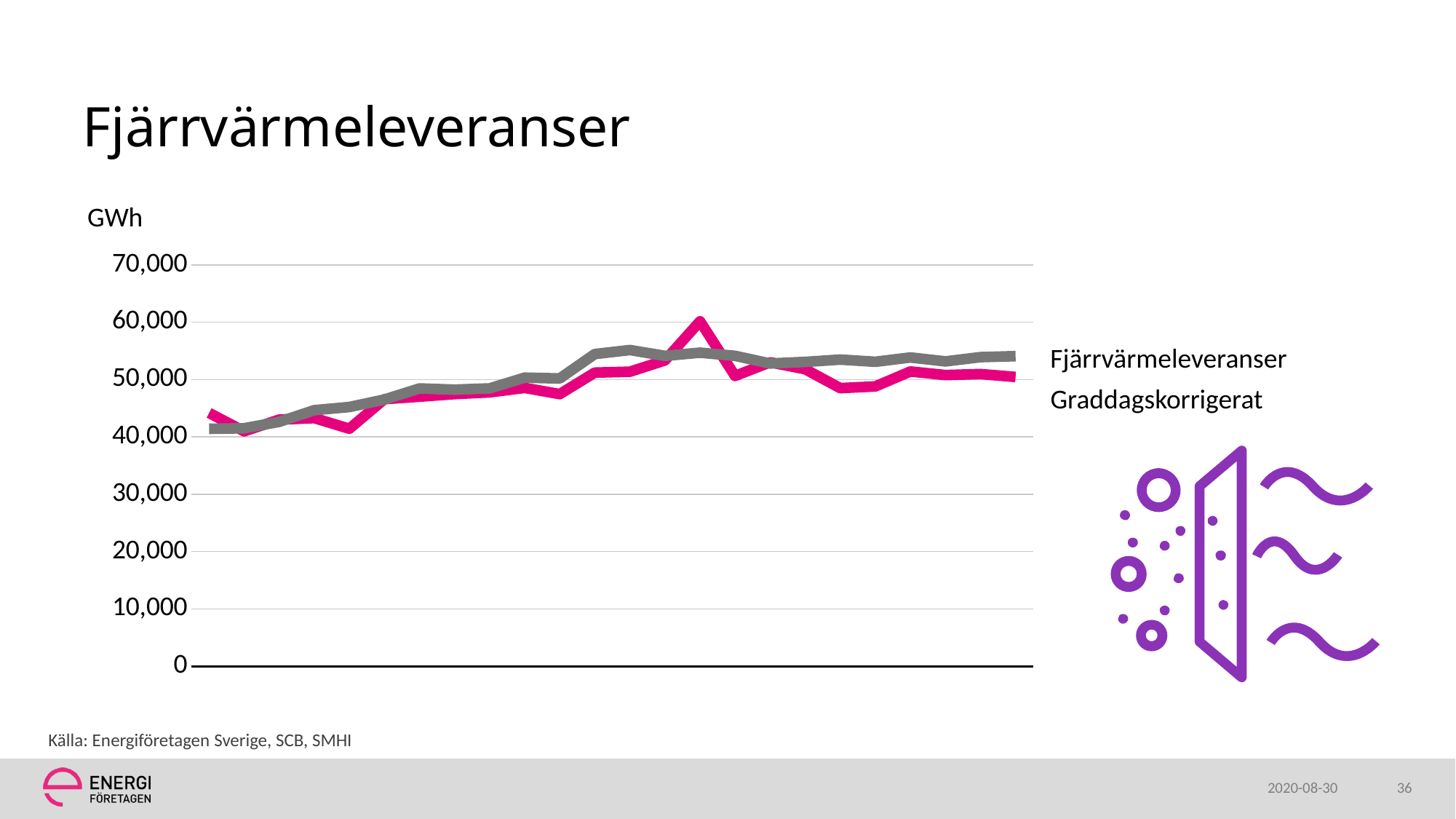
At the right end of the chart, which series is higher, Fjärrvärmeleveranser or Graddagskorrigerat? Graddagskorrigerat Is the lowest value of the Fjärrvärmeleveranser series greater or less than 30,000? greater What are the names of the two series in the legend? Fjärrvärmeleveranser and Graddagskorrigerat Is the highest value of the Graddagskorrigerat series greater or less than 60,000? less Which series reaches the highest peak on the chart? Fjärrvärmeleveranser What unit is shown on the y axis of the chart? GWh Do the values of the Fjärrvärmeleveranser series rise or fall overall from left to right? rise What kind of chart is shown on the slide? line chart Do the values of the Graddagskorrigerat series rise or fall overall from left to right? rise Is the last value of the Graddagskorrigerat series greater or less than 50,000? greater How many series does the legend list? 2